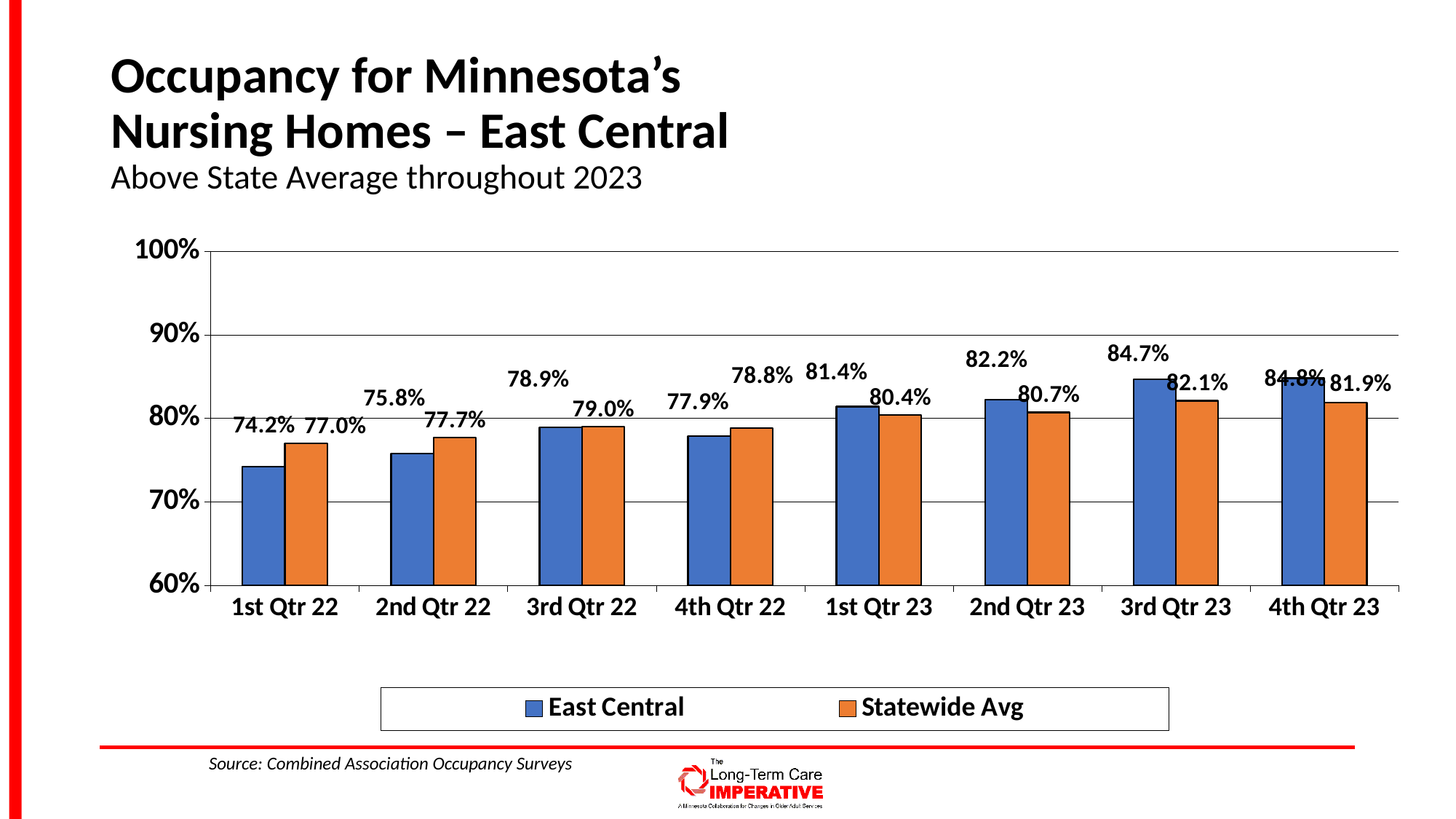
In 1st Qtr 22, which is larger: East Central or Statewide Avg? Statewide Avg Which colour represents the East Central series in the legend? Blue How many quarters are shown on the x axis? 8 Is the East Central value for 2nd Qtr 22 greater or less than 80%? less What kind of chart is shown on the slide? Bar chart In which quarter is the Statewide Avg occupancy lowest? 1st Qtr 22 What is the difference between the East Central and Statewide Avg values in 3rd Qtr 23? 2.6 percentage points How many series does the legend list? 2 What is the East Central occupancy value for 1st Qtr 23? 81.4% What is the Statewide Avg occupancy value for 2nd Qtr 22? 77.7% In which quarter is the East Central occupancy lowest? 1st Qtr 22 What is the East Central occupancy value for 4th Qtr 22? 77.9%